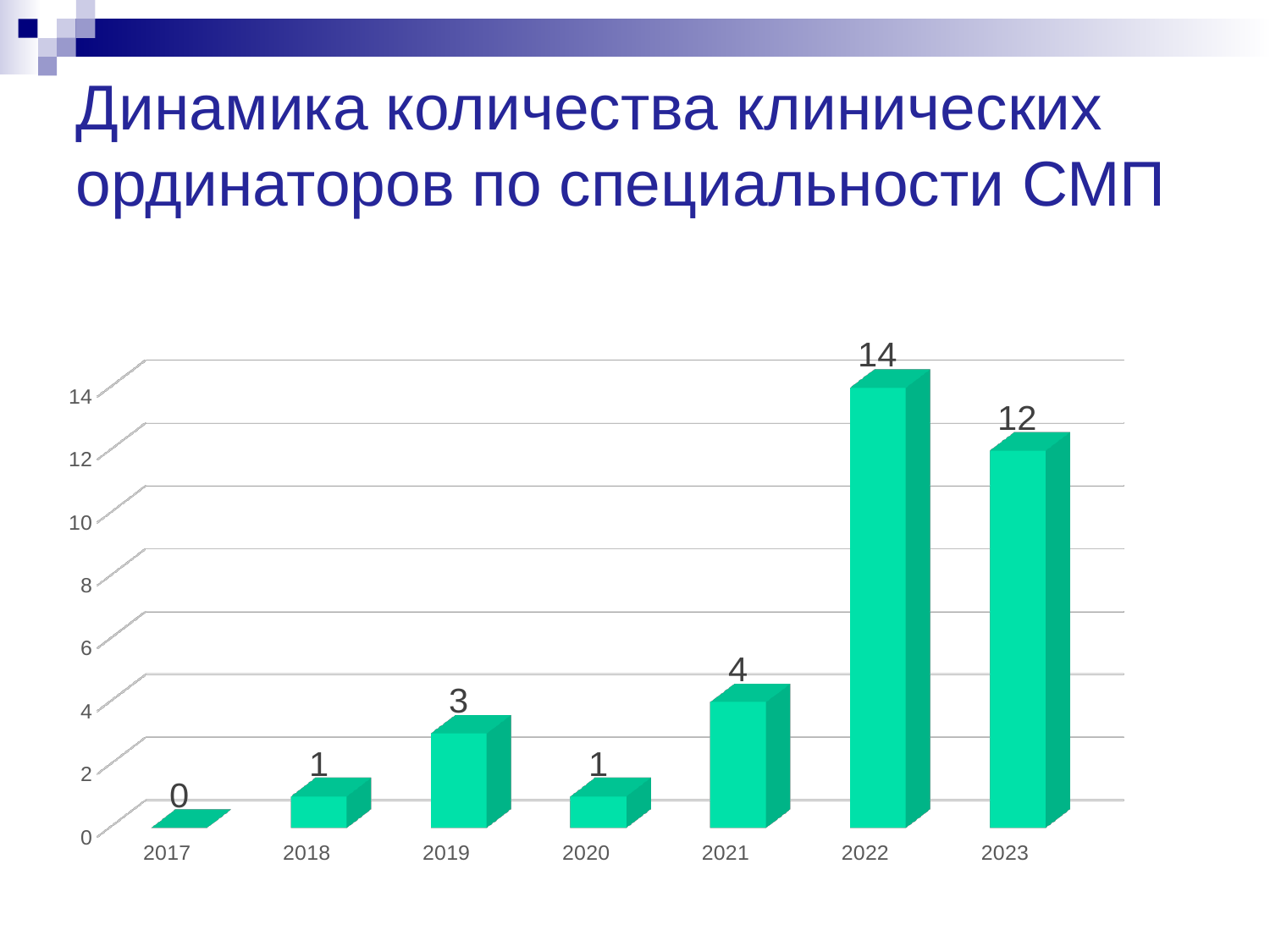
What is the value for 2019? 3 What is the value for 2022? 14 What kind of chart is shown on the slide? bar chart How many years are shown on the x axis? 7 Is the value for 2023 greater or less than 10? greater What is the difference between the values for 2021 and 2020? 3 What is the value for 2017? 0 Which year has the highest value? 2022 Which is larger, the value for 2021 or the value for 2019? 2021 What is the difference between the values for 2022 and 2023? 2 What is the title of the slide? Динамика количества клинических ординаторов по специальности СМП Which year has the lowest value? 2017